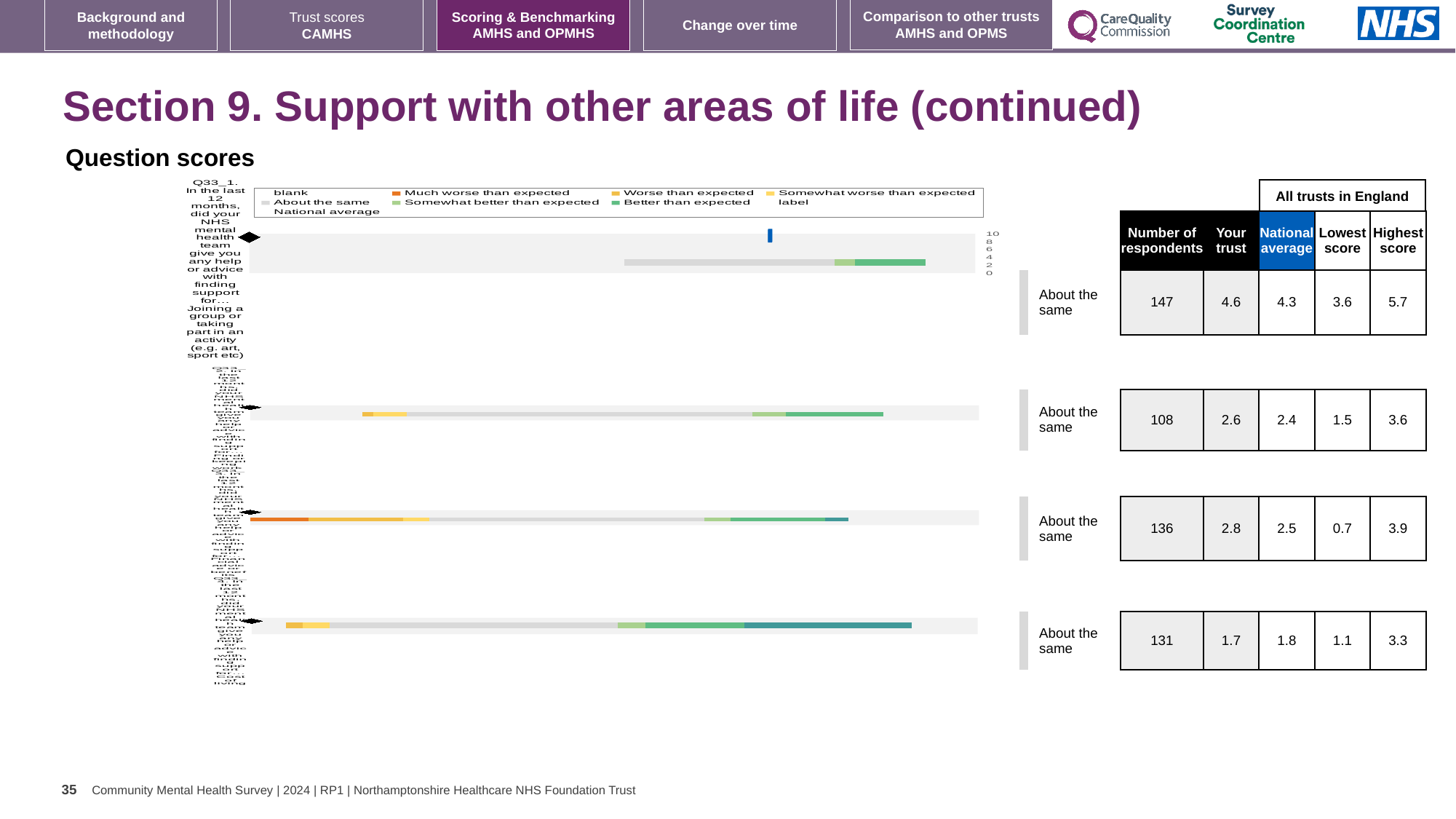
In the table beside the chart, what is the national average for the first question (Joining a group or taking part in an activity)? 4.3 For the first question (Joining a group or taking part in an activity), what is the difference between the 'Your trust' score and the national average? 0.3 In the table beside the chart, what is the highest score for the second row? 3.6 How many entries does the chart legend list? 9 What benchmark category is shown next to every bar in the chart? About the same In the table beside the chart, which row has the highest number of respondents? the first row (147) In the table beside the chart, what is the 'Your trust' score for the first question (Joining a group or taking part in an activity)? 4.6 In the table beside the chart, what is the number of respondents for the first question (Joining a group or taking part in an activity)? 147 How many question bars are plotted in the chart? 4 What kind of chart is shown on the slide? bar chart For the first question (Joining a group or taking part in an activity), which is larger: the 'Your trust' score or the national average? Your trust In the table beside the chart, what is the lowest score for the third row? 0.7